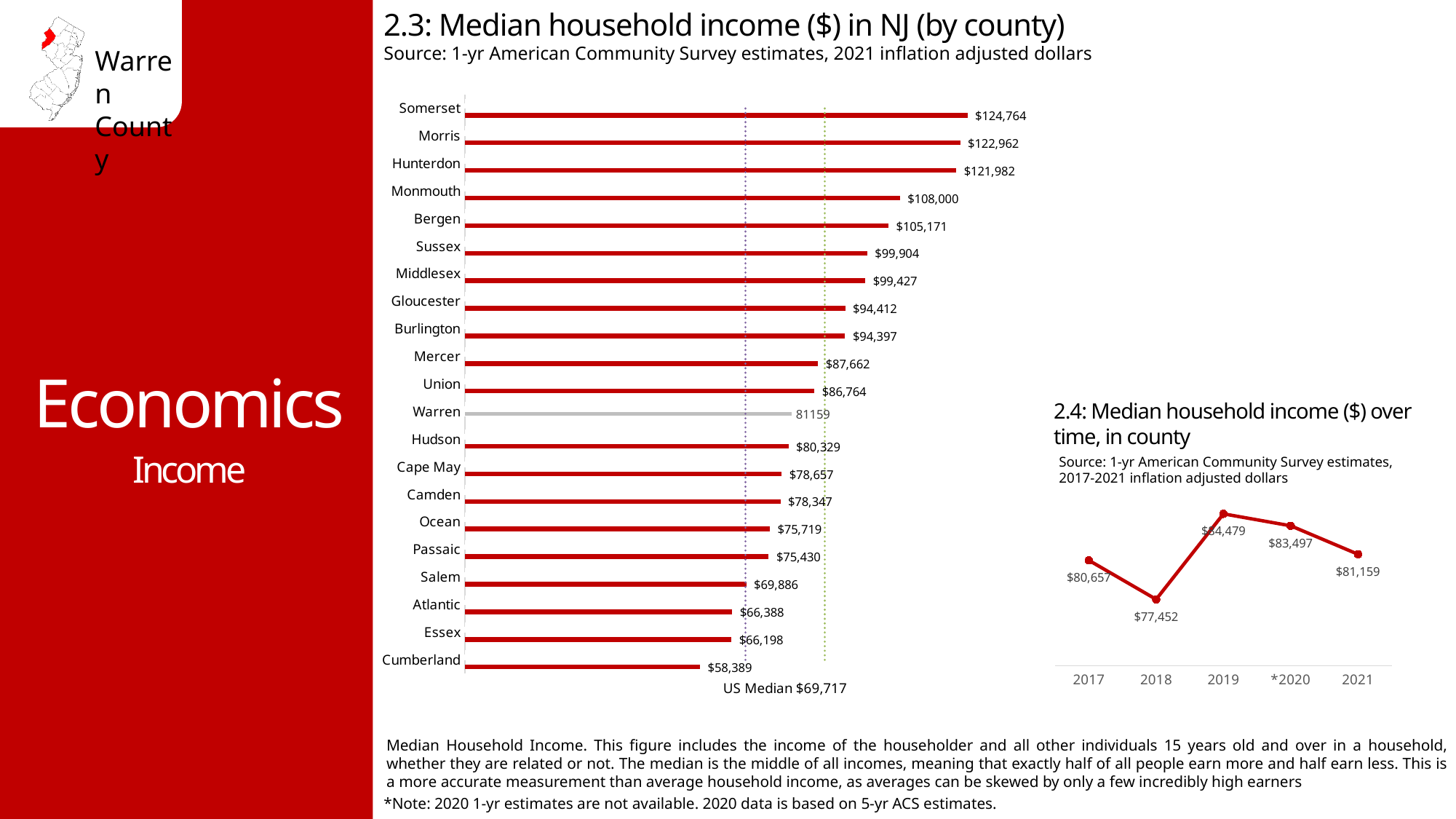
In chart 2.3 (Median household income by county), what is the median household income for Somerset? $124,764 In chart 2.4 (Median household income over time, in county), which year had the lowest median household income? 2018 In chart 2.3 (Median household income by county), what is the difference between the median household incomes of Morris and Hunterdon? $980 In chart 2.3 (Median household income by county), which county has the highest median household income? Somerset In chart 2.4 (Median household income over time, in county), what is the difference between the 2017 and 2021 values? $502 In chart 2.3 (Median household income by county), what value is shown for the US Median? $69,717 In chart 2.3 (Median household income by county), which county has the lowest median household income? Cumberland In chart 2.3 (Median household income by county), what is the median household income for Cumberland? $58,389 In chart 2.4 (Median household income over time, in county), what was the median household income in 2018? $77,452 What type of chart is chart 2.4 (Median household income over time, in county)? Line chart In chart 2.3 (Median household income by county), how many counties are shown? 21 In chart 2.3 (Median household income by county), which has a higher median household income, Bergen or Monmouth? Monmouth